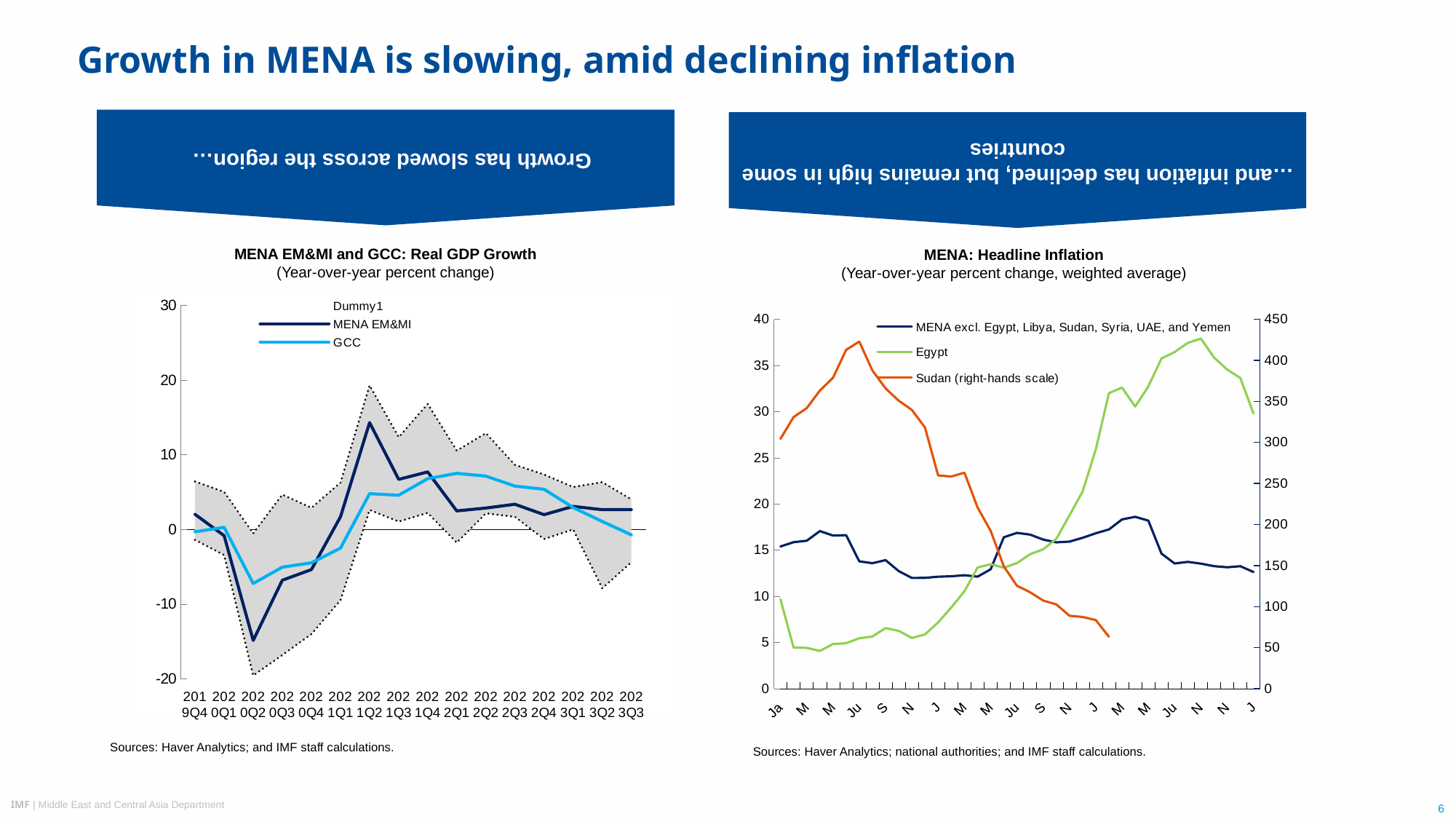
In the right chart 'MENA: Headline Inflation', which series is plotted on the right-hand scale? Sudan In the left chart 'MENA EM&MI and GCC: Real GDP Growth', which series is lower in 2020Q2, MENA EM&MI or GCC? MENA EM&MI In the left chart 'MENA EM&MI and GCC: Real GDP Growth', in which quarter does the MENA EM&MI line reach its highest value? 2021Q2 In the left chart 'MENA EM&MI and GCC: Real GDP Growth', how many series does the legend list? 3 In the left chart 'MENA EM&MI and GCC: Real GDP Growth', is the MENA EM&MI value for 2021Q2 greater or less than 10? greater In the right chart 'MENA: Headline Inflation', how many series does the legend list? 3 In the right chart 'MENA: Headline Inflation', is the peak value of the Sudan line greater or less than 400 on the right-hand scale? greater In the left chart 'MENA EM&MI and GCC: Real GDP Growth', in which quarter does the MENA EM&MI line reach its lowest value? 2020Q2 In the right chart 'MENA: Headline Inflation', does the Sudan line generally rise or fall from its peak to the end of the series? Fall What type of chart is the left chart titled 'MENA EM&MI and GCC: Real GDP Growth'? Line chart In the left chart 'MENA EM&MI and GCC: Real GDP Growth', is the MENA EM&MI value for 2020Q2 greater or less than -10? less In the left chart 'MENA EM&MI and GCC: Real GDP Growth', how many quarters are shown on the x axis? 16